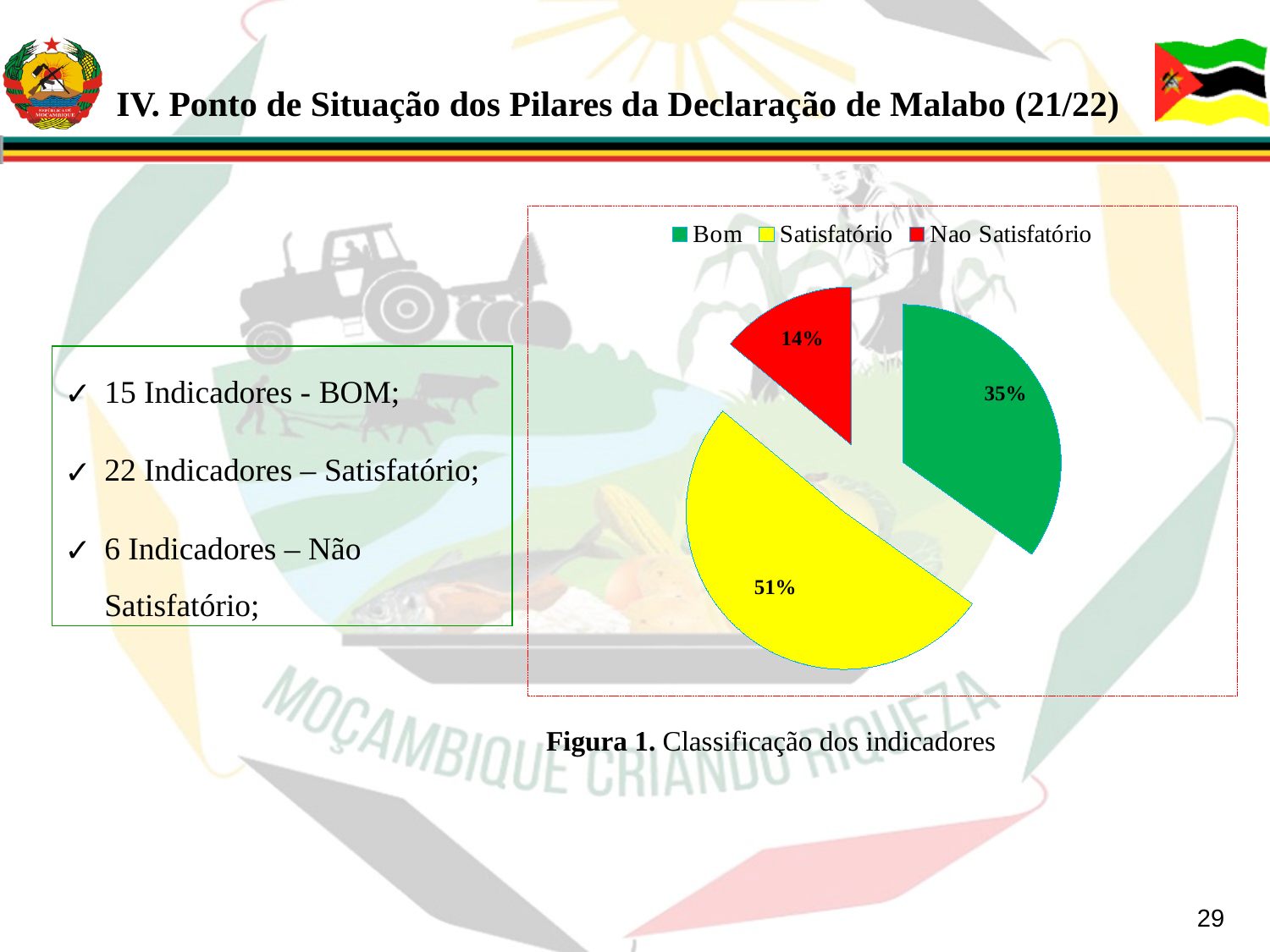
What share of the pie does the Satisfatório slice represent? 51% Which slice is larger, Bom or Nao Satisfatório? Bom What is the difference in percentage points between the Bom and Nao Satisfatório slices? 21 What kind of chart is shown on the slide? pie chart What share of the pie does the Bom slice represent? 35% What colour is the Satisfatório slice? yellow How many categories does the pie chart have? 3 Which category has the largest slice of the pie? Satisfatório What is the difference in percentage points between the Satisfatório and Bom slices? 16 What is the caption of the figure below the chart? Figura 1. Classificação dos indicadores Which category has the smallest slice of the pie? Nao Satisfatório What share of the pie does the Nao Satisfatório slice represent? 14%